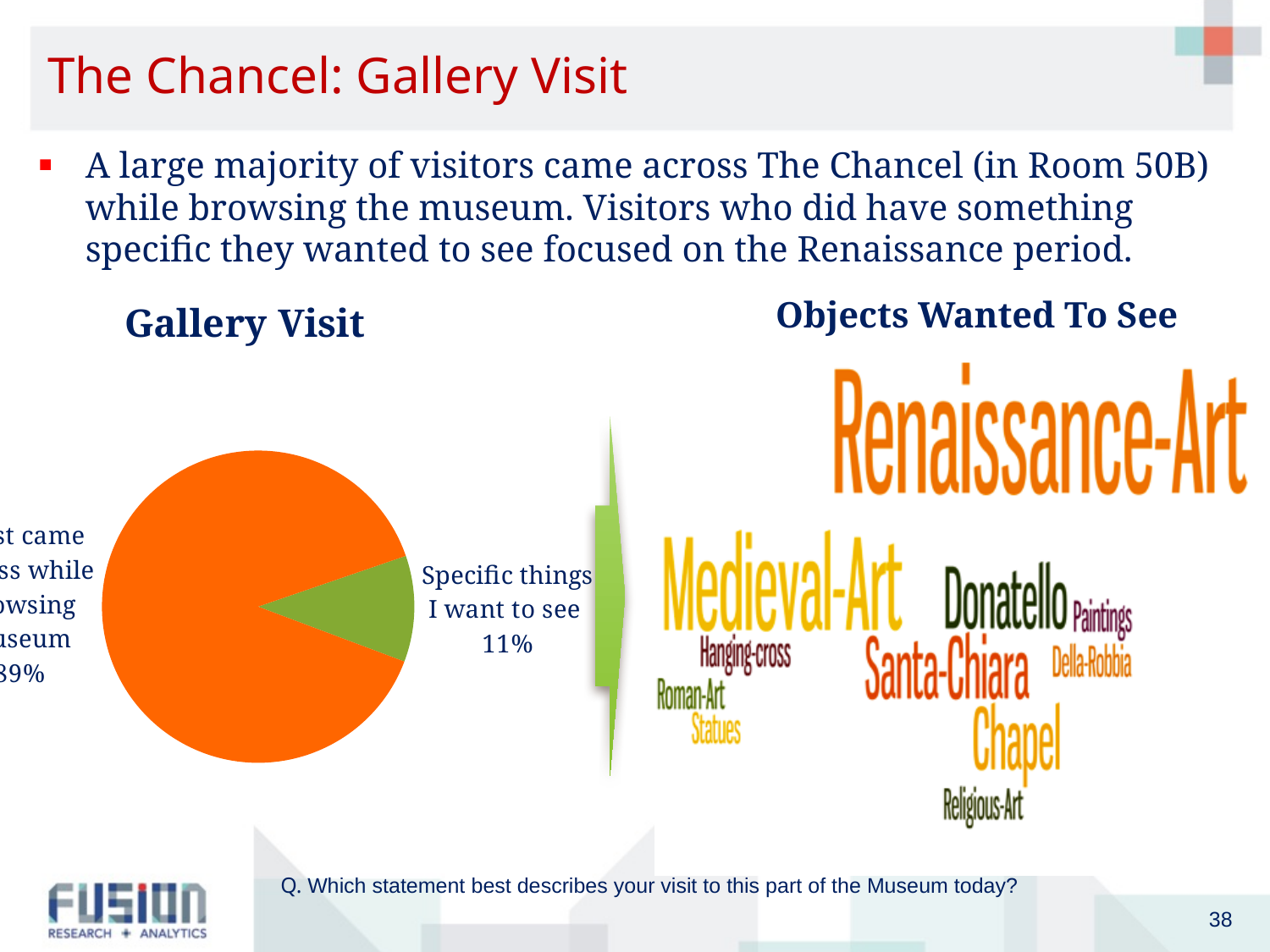
What colour is the 'Specific things I want to see' slice in the Gallery Visit pie chart? green How many slices does the Gallery Visit pie chart have? 2 In the Gallery Visit pie chart, which slice is the smaller one? Specific things I want to see In the Gallery Visit pie chart, is the share for 'Specific things I want to see' greater or less than 50%? less What is the title of the pie chart on the left of the slide? Gallery Visit What kind of chart is the Gallery Visit chart? pie chart What share of the Gallery Visit pie does the 'Specific things I want to see' slice represent? 11% In the Gallery Visit pie chart, what percentage of visitors said there were specific things they wanted to see? 11%